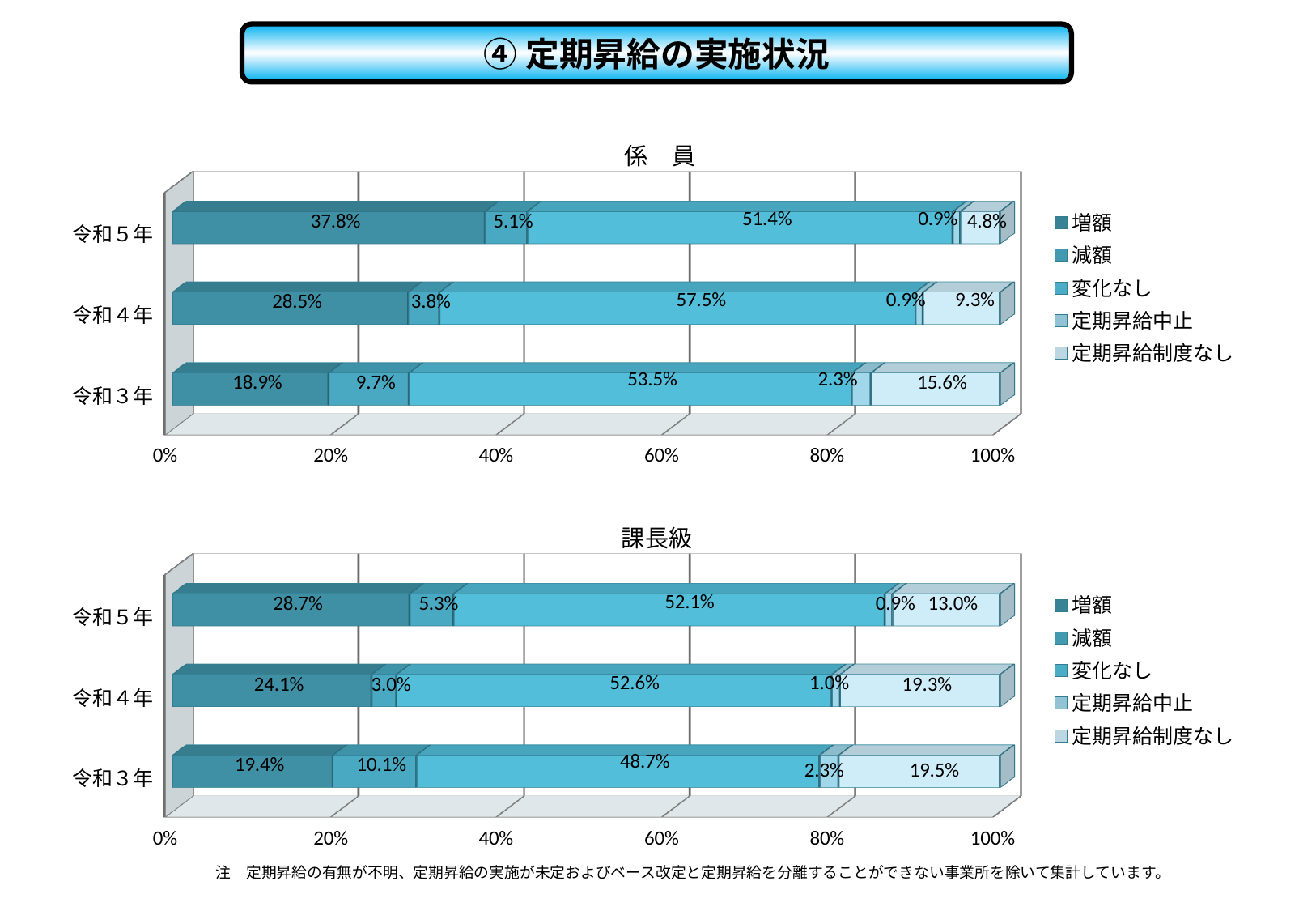
How many series does the legend of the 課長級 chart list? 5 In the 係員 chart, what is the value of 変化なし for 令和４年? 57.5% In the 係員 chart, what is the difference between the 定期昇給制度なし values for 令和３年 and 令和５年? 10.8% In the 課長級 chart, which year has the lowest value for 定期昇給制度なし? 令和５年 What is the title of the lower chart on the slide? 課長級 How many years are shown in the 係員 chart? 3 In the 課長級 chart, what is the value of 減額 for 令和３年? 10.1% In the 課長級 chart, which is larger: 増額 for 令和５年 or 増額 for 令和４年? 増額 for 令和５年 In the 係員 chart, what is the value of 増額 for 令和５年? 37.8% In the 係員 chart, which year has the highest value for 増額? 令和５年 In the 課長級 chart, what is the value of 定期昇給制度なし for 令和４年? 19.3% What kind of chart is the 係員 chart? Stacked bar chart